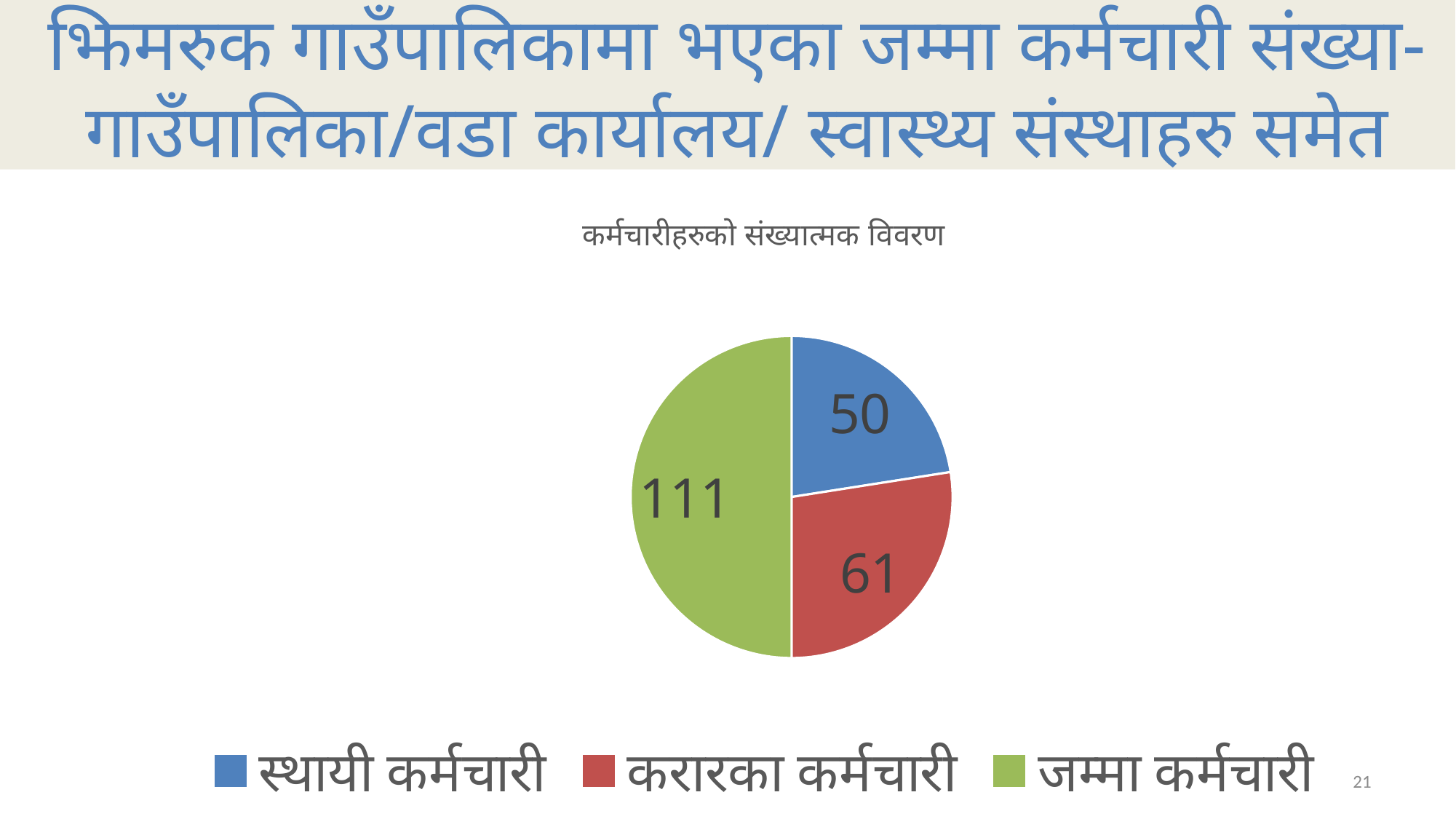
What colour is the slice for करारका कर्मचारी? red What is the value for जम्मा कर्मचारी in the pie chart? 111 What is the title of the chart? कर्मचारीहरुको संख्यात्मक विवरण Which is larger, the value for करारका कर्मचारी or the value for स्थायी कर्मचारी? करारका कर्मचारी What is the difference between the values for करारका कर्मचारी and स्थायी कर्मचारी? 11 Which category has the smallest slice in the pie chart? स्थायी कर्मचारी What type of chart is shown on the slide? pie chart What share of the pie does the जम्मा कर्मचारी slice represent? 50% Which category has the largest slice in the pie chart? जम्मा कर्मचारी What is the value for करारका कर्मचारी in the pie chart? 61 What is the value for स्थायी कर्मचारी in the pie chart? 50 How many slices does the pie chart have? 3